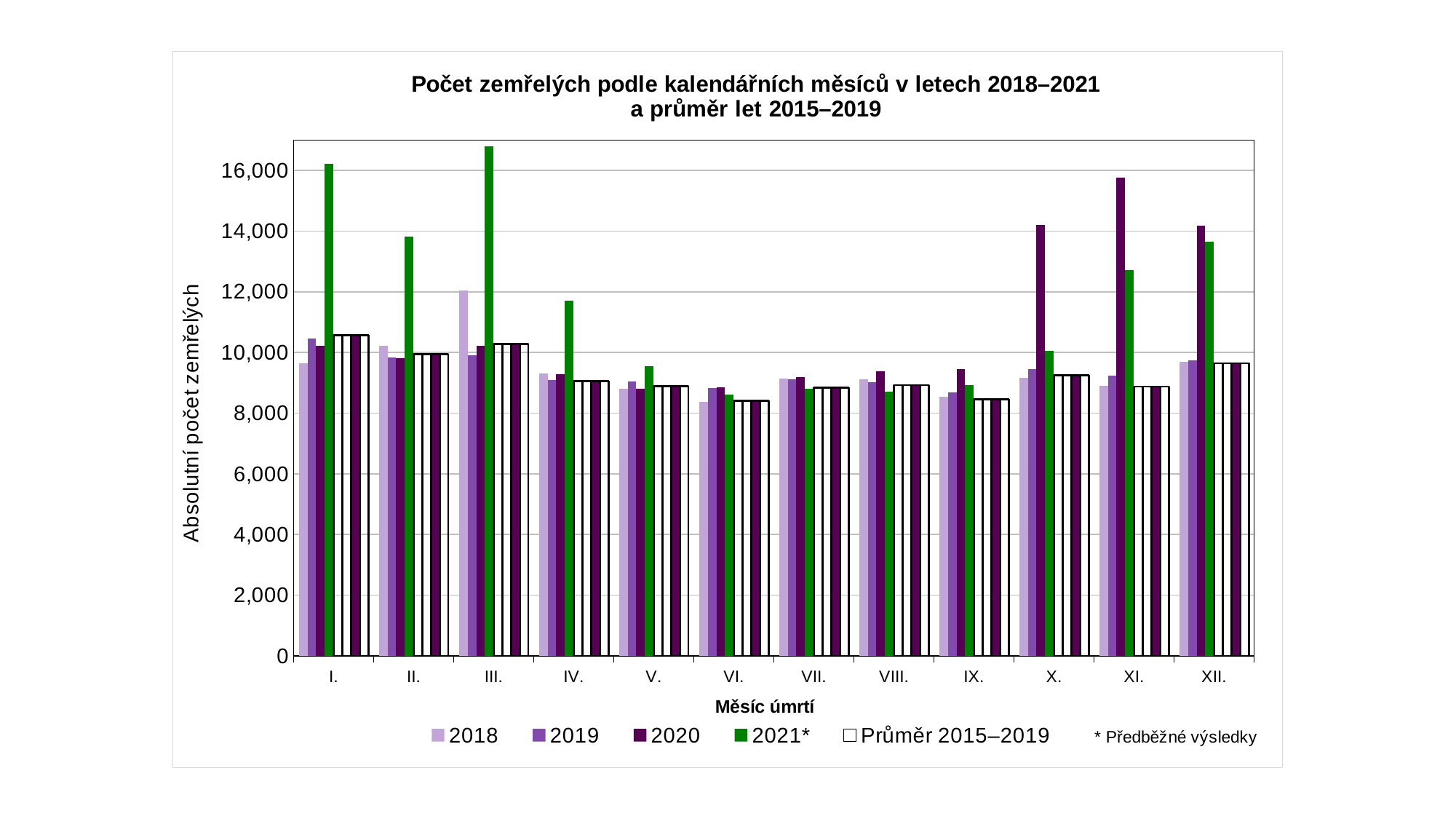
Is the 2021* value for month I. greater or less than 14,000? greater What kind of chart is shown on the slide? bar chart In which month is the 2020 value the highest? XI. What is the title of the x axis? Měsíc úmrtí For month X., which is larger: the 2020 value or the 2021* value? 2020 In which month is the 2021* value the highest? III. Is the 2021* value for month XI. greater or less than 12,000? greater Is the 2018 value for month III. greater or less than 10,000? greater How many months (categories) are shown on the x axis? 12 For month I., which is larger: the 2020 value or the 2021* value? 2021* How many series does the legend list? 5